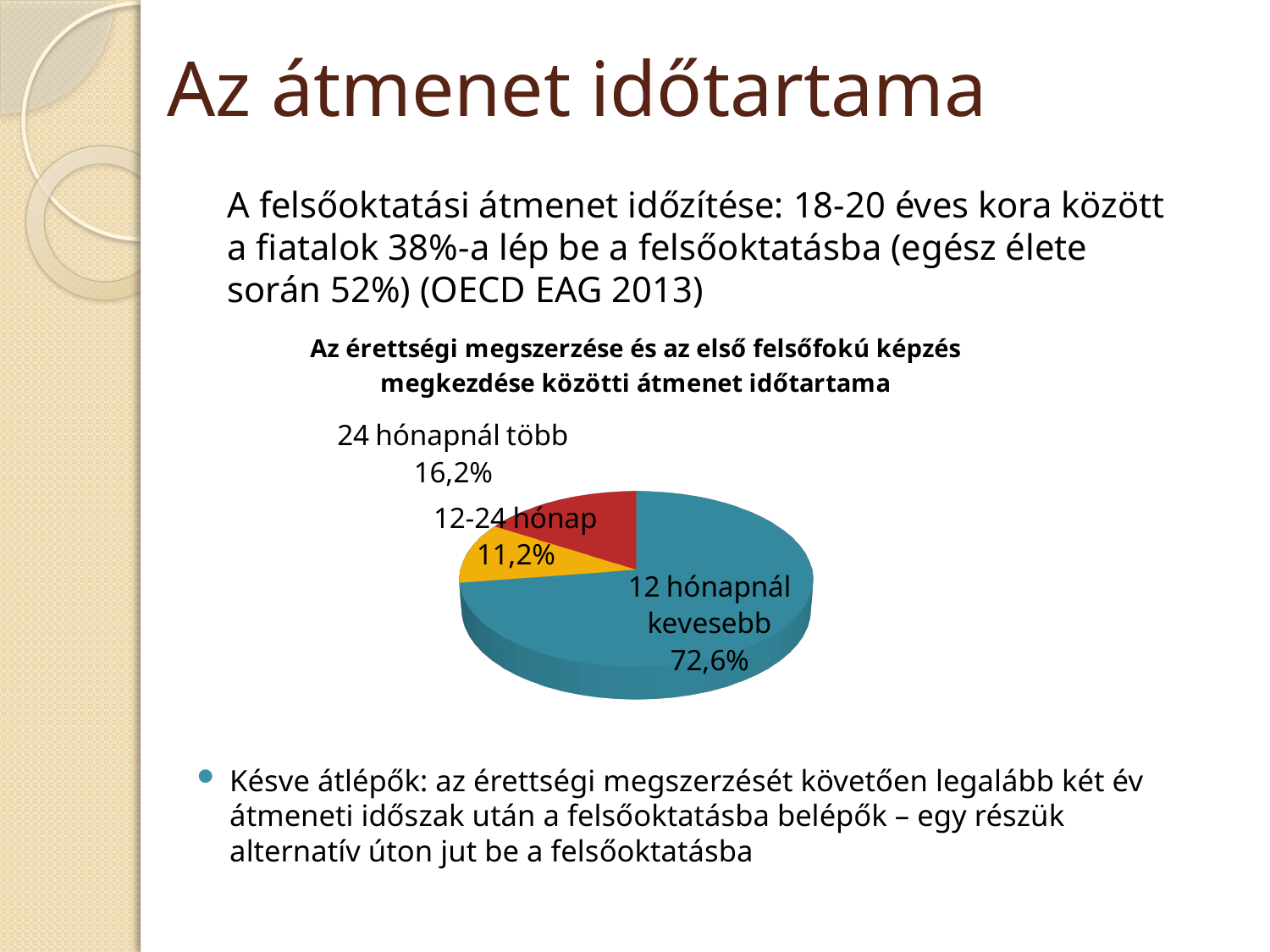
What type of chart is shown on the slide? pie chart What share of the pie does the "24 hónapnál több" slice represent? 16,2% What is the title of the pie chart? Az érettségi megszerzése és az első felsőfokú képzés megkezdése közötti átmenet időtartama How many slices does the pie chart have? 3 Which is larger: the share for "24 hónapnál több" or the share for "12-24 hónap"? 24 hónapnál több What colour is the "12 hónapnál kevesebb" slice of the pie? teal (blue-green) Which category has the largest share of the pie? 12 hónapnál kevesebb Which category has the smallest share of the pie? 12-24 hónap What is the difference in percentage points between the "12 hónapnál kevesebb" slice and the "24 hónapnál több" slice? 56,4 What share of the pie does the "12-24 hónap" slice represent? 11,2% What share of the pie does the "12 hónapnál kevesebb" slice represent? 72,6% What is the difference in percentage points between the "24 hónapnál több" slice and the "12-24 hónap" slice? 5